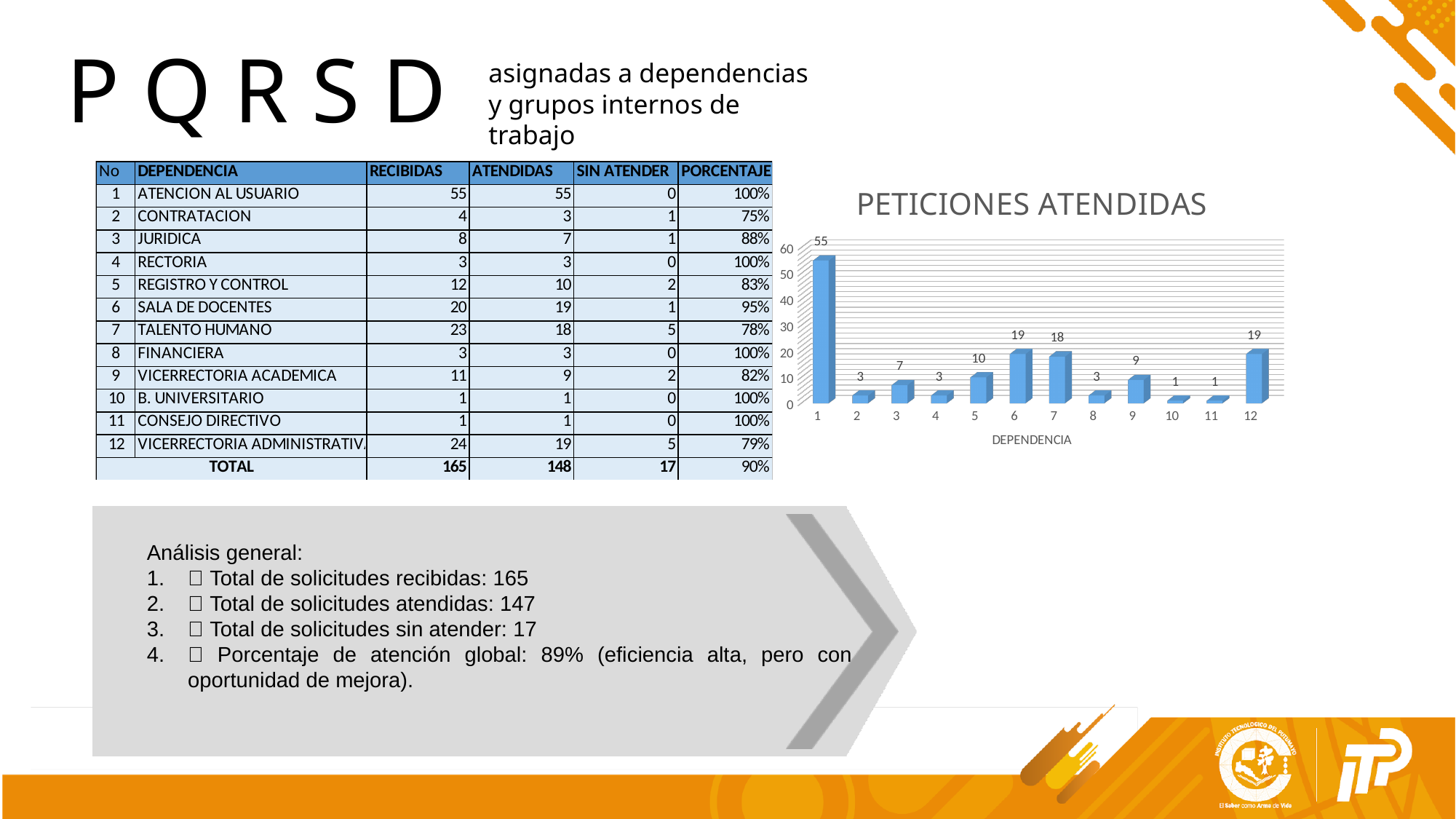
What is the value for category 6 in the chart? 19 How many categories are plotted on the x axis of the chart? 12 What is the value for category 9 in the chart? 9 Which is larger, the value for category 5 or the value for category 3? category 5 Is the value for category 1 greater or less than 50? greater What is the value for category 1 in the chart? 55 What is the x-axis title of the chart? DEPENDENCIA Which category has the highest value in the chart? 1 What is the title of the chart? PETICIONES ATENDIDAS What is the difference between the values for category 1 and category 7? 37 What is the difference between the values for category 6 and category 2? 16 What type of chart is shown on the slide? bar chart